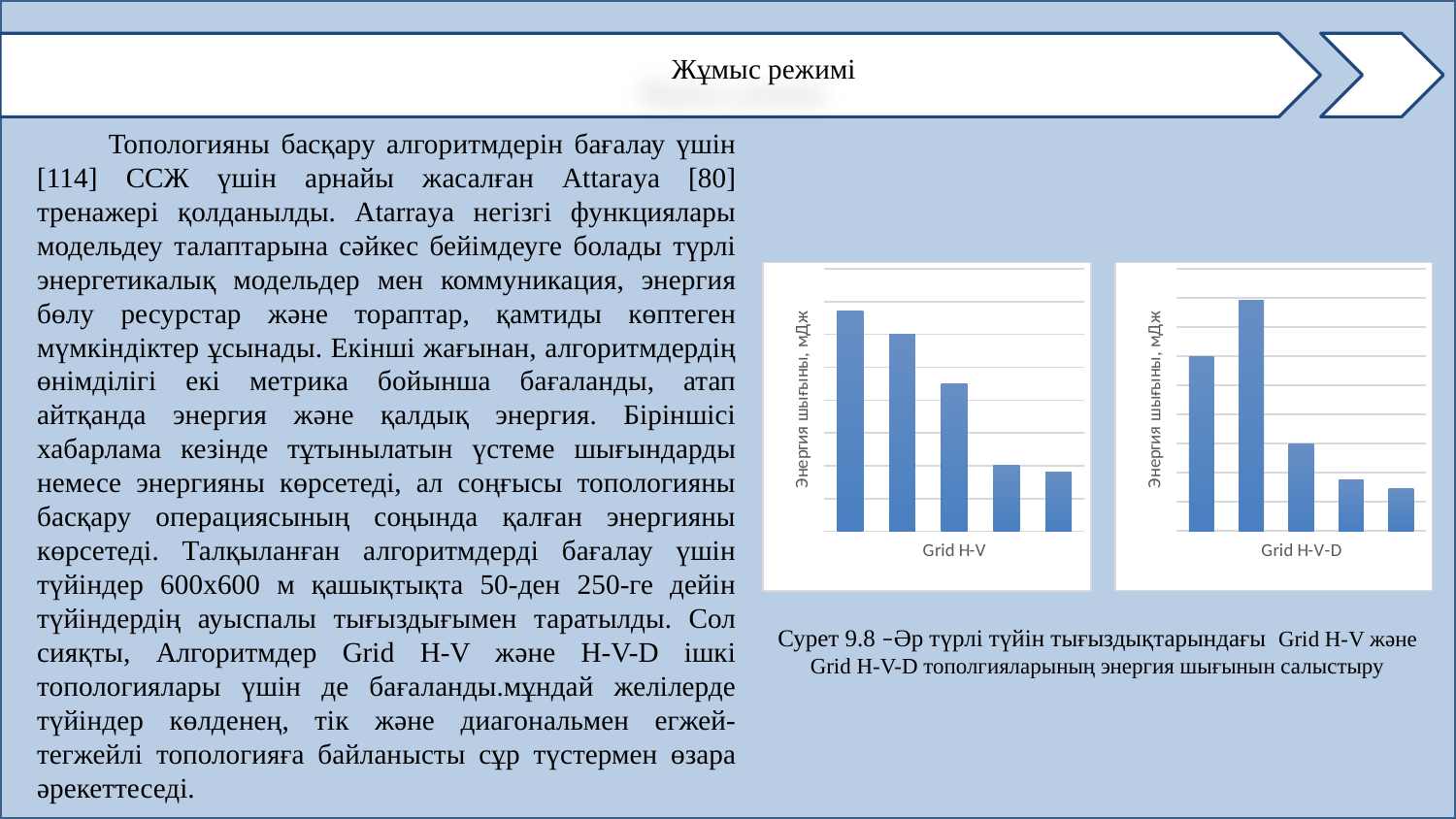
In the Grid H-V chart, which bar is the tallest? the first (leftmost) bar In the Grid H-V chart, which bar is the shortest? the last (rightmost) bar What is the label on the vertical axis of the two charts? Энергия шығыны, мДж In the Grid H-V-D chart, which bar is the tallest? the second bar from the left How many bars are plotted in the Grid H-V-D chart? 5 What kind of chart is the Grid H-V chart? bar chart How many bars are plotted in the Grid H-V chart? 5 In the Grid H-V-D chart, which bar is the shortest? the last (rightmost) bar What kind of chart is the Grid H-V-D chart? bar chart In the Grid H-V chart, do the bar heights rise or fall from left to right? fall In the Grid H-V-D chart, is the first bar or the second bar taller? the second bar In the Grid H-V chart, is the third bar or the fourth bar taller? the third bar